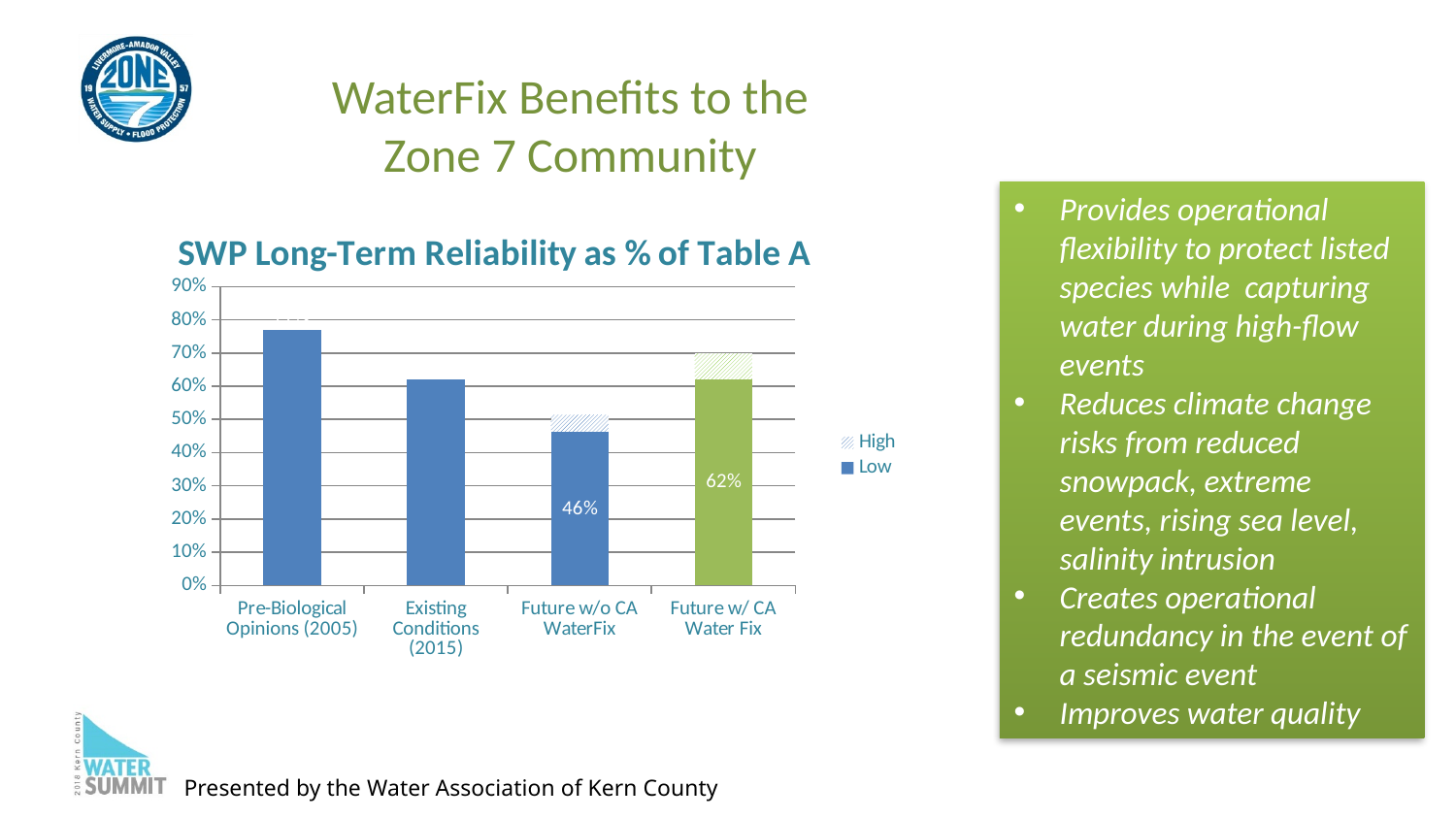
How many series does the legend list? 2 Is the Low value for Pre-Biological Opinions (2005) greater or less than 70%? greater How many categories are shown on the x axis? 4 What is the difference between the Low values for Future w/ CA Water Fix and Future w/o CA WaterFix? 16 percentage points Which category has the highest Low bar? Pre-Biological Opinions (2005) What is the Low value for Future w/o CA WaterFix? 46% What is the title of the chart? SWP Long-Term Reliability as % of Table A Which category has the lowest Low bar? Future w/o CA WaterFix Which has a larger Low value, Future w/o CA WaterFix or Future w/ CA Water Fix? Future w/ CA Water Fix What is the Low value for Future w/ CA Water Fix? 62% What kind of chart is shown on the slide? bar chart Is the Low value for Existing Conditions (2015) greater or less than 70%? less